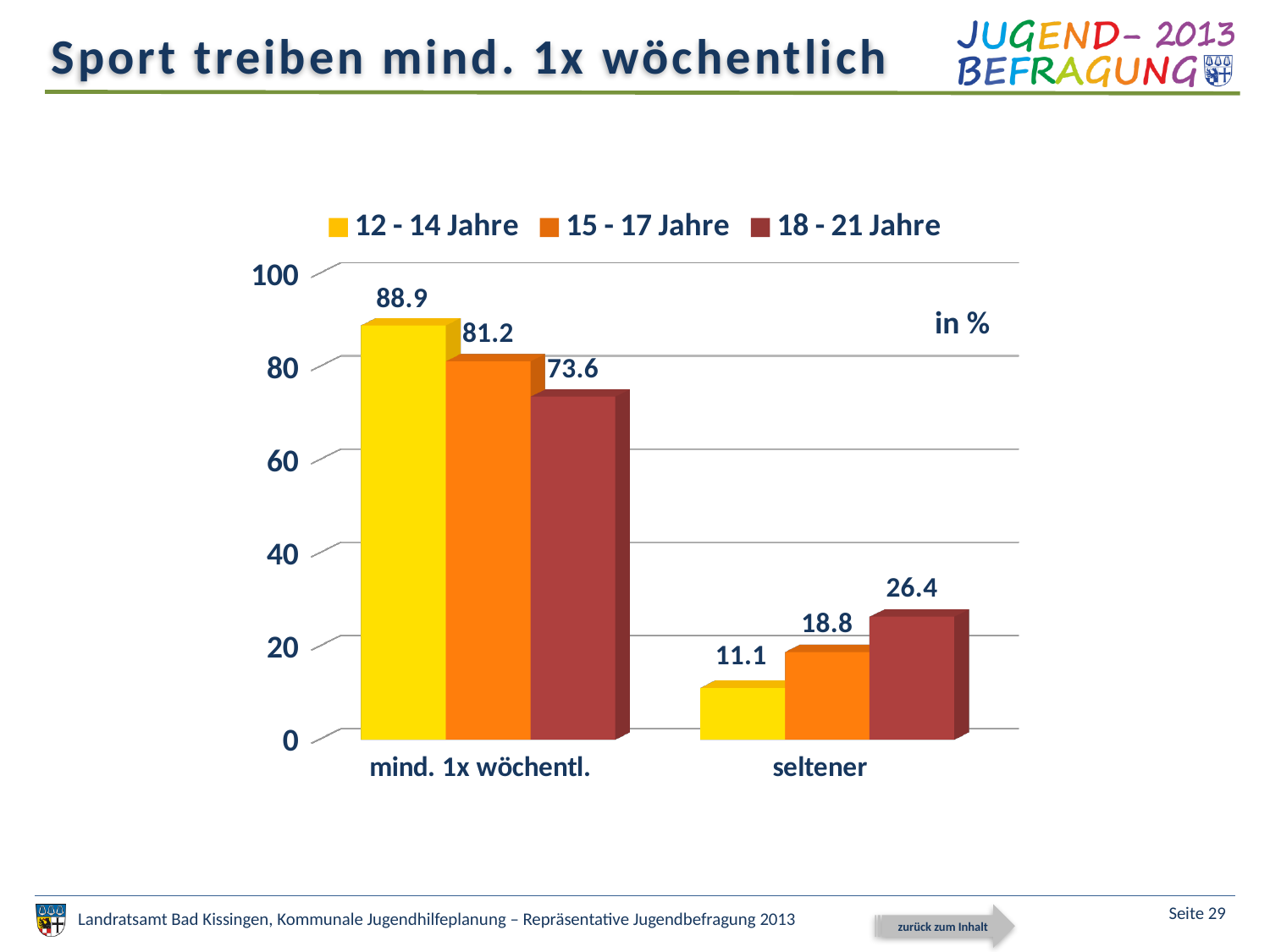
Is the value for 18 - 21 Jahre in the 'mind. 1x wöchentl.' category greater or less than 80? less Which age group has the lowest value in the 'seltener' category? 12 - 14 Jahre What is the value for the 18 - 21 Jahre series in the 'seltener' category? 26.4 What kind of chart is shown on the slide? bar chart What is the difference between the 12 - 14 Jahre and 18 - 21 Jahre values in the 'mind. 1x wöchentl.' category? 15.3 How many categories are shown on the x axis? 2 What is the value for the 15 - 17 Jahre series in the 'seltener' category? 18.8 What is the value for the 12 - 14 Jahre series in the 'mind. 1x wöchentl.' category? 88.9 Which age group has the highest value in the 'mind. 1x wöchentl.' category? 12 - 14 Jahre What unit is indicated for the values in the chart? in % How many series does the legend list? 3 Which is larger: the 15 - 17 Jahre value for 'seltener' or the 18 - 21 Jahre value for 'seltener'? 18 - 21 Jahre